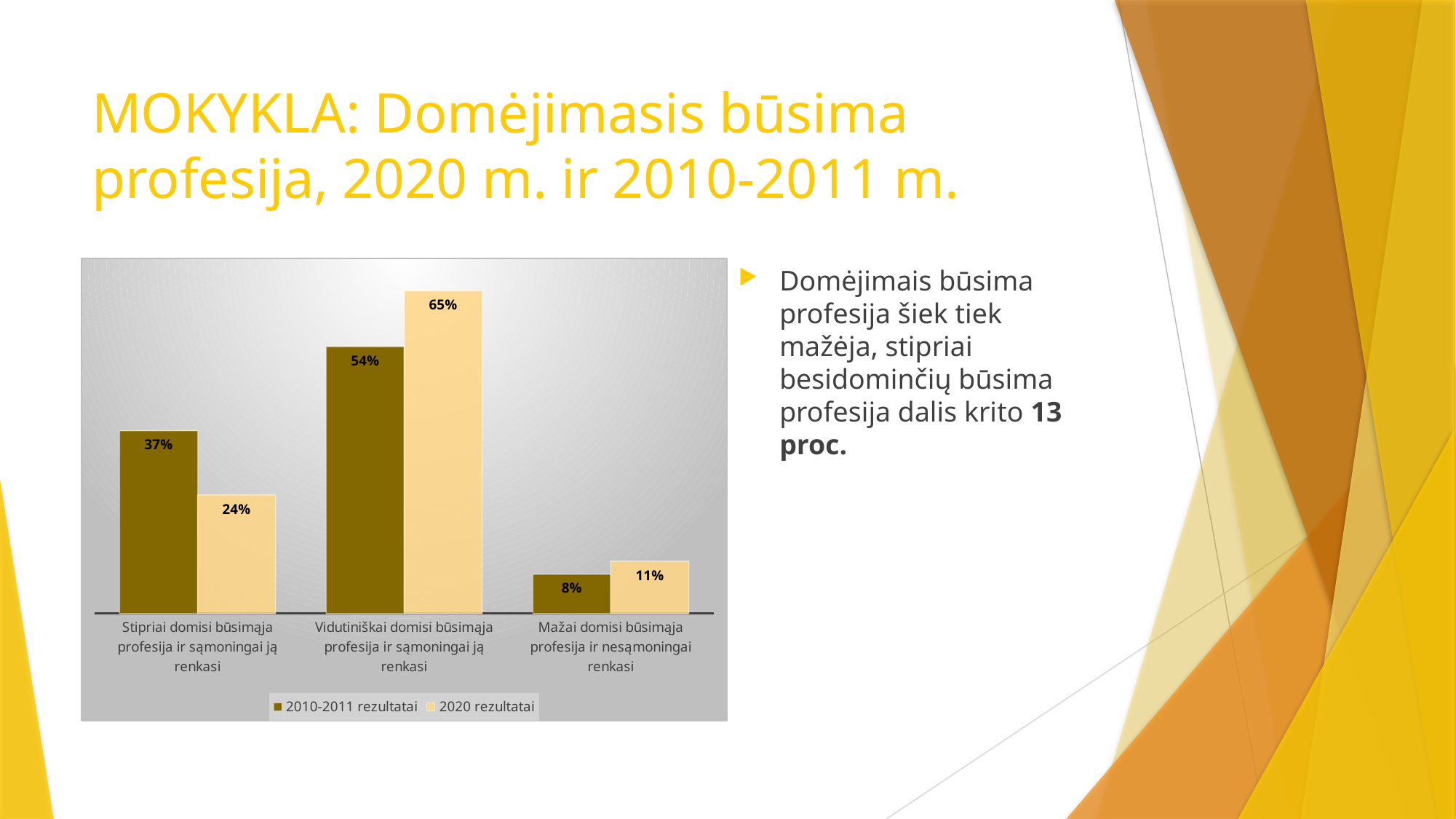
What is the value for "Vidutiniškai domisi būsimąja profesija ir sąmoningai ją renkasi" in the 2020 rezultatai series? 65% What is the value for "Stipriai domisi būsimąja profesija ir sąmoningai ją renkasi" in the 2020 rezultatai series? 24% What is the difference between the 2010-2011 rezultatai and 2020 rezultatai values for "Stipriai domisi būsimąja profesija ir sąmoningai ją renkasi"? 13% What is the difference between the 2020 rezultatai and 2010-2011 rezultatai values for "Vidutiniškai domisi būsimąja profesija ir sąmoningai ją renkasi"? 11% Which category has the lowest value in the 2010-2011 rezultatai series? Mažai domisi būsimąja profesija ir nesąmoningai renkasi Which category has the highest value in the 2020 rezultatai series? Vidutiniškai domisi būsimąja profesija ir sąmoningai ją renkasi How many categories are shown on the x axis of the chart? 3 How many series does the chart legend list? 2 What is the value for "Mažai domisi būsimąja profesija ir nesąmoningai renkasi" in the 2010-2011 rezultatai series? 8% What is the value for "Stipriai domisi būsimąja profesija ir sąmoningai ją renkasi" in the 2010-2011 rezultatai series? 37% For "Mažai domisi būsimąja profesija ir nesąmoningai renkasi", which series has the larger value, 2010-2011 rezultatai or 2020 rezultatai? 2020 rezultatai What kind of chart is shown on the slide? Bar chart